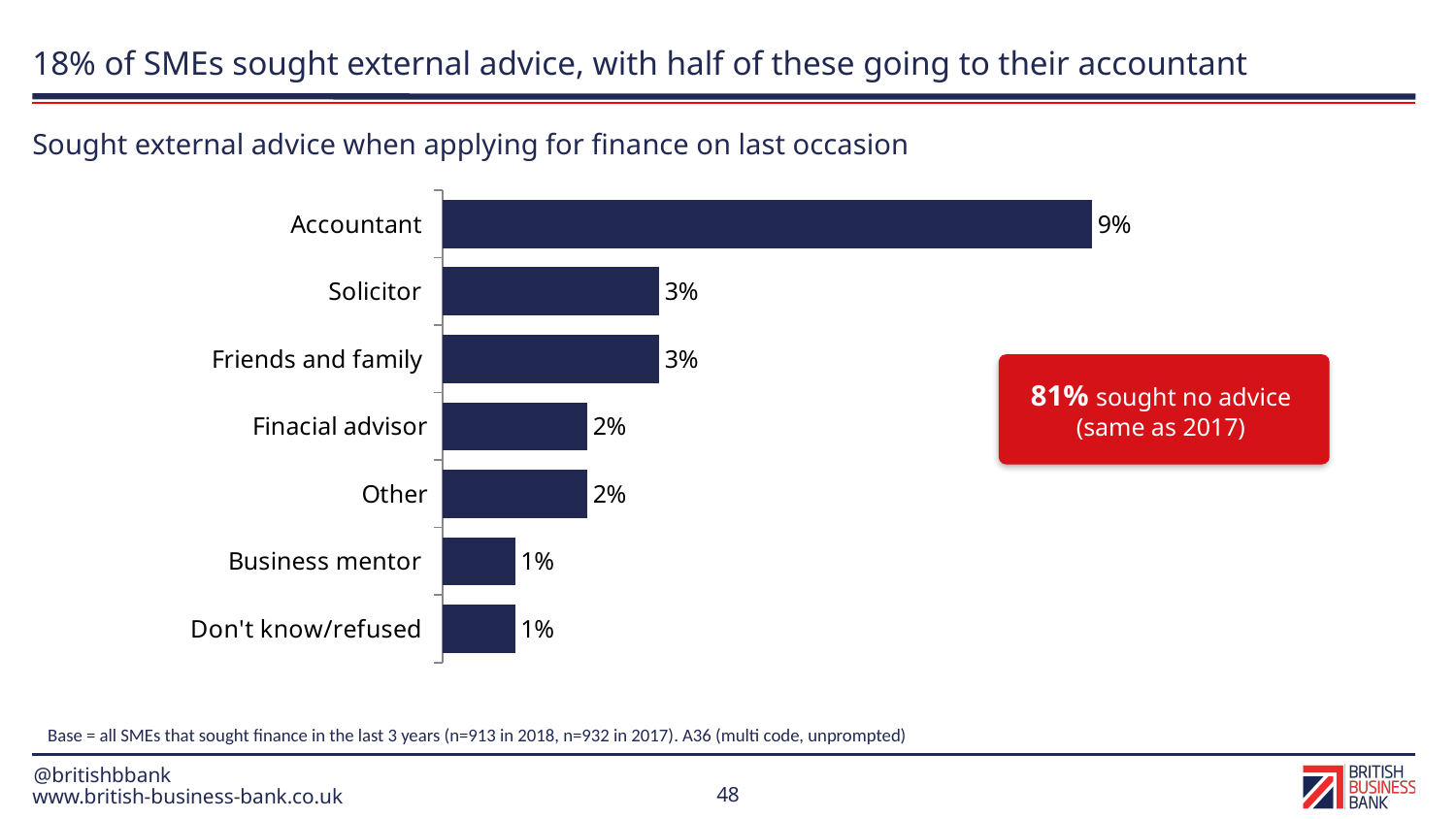
What percentage of SMEs sought advice from an accountant? 9% What is the value for Business mentor? 1% What is the title of the chart? Sought external advice when applying for finance on last occasion What kind of chart is shown on the slide? Bar chart What is the value for Finacial advisor? 2% What is the difference between the values for Accountant and Solicitor? 6% Which is larger, the value for Friends and family or the value for Other? Friends and family According to the callout box, what percentage of SMEs sought no advice? 81% How many categories are shown in the chart? 7 Which category has the highest value? Accountant What is the value for Solicitor? 3% What is the difference between the values for Other and Don't know/refused? 1%